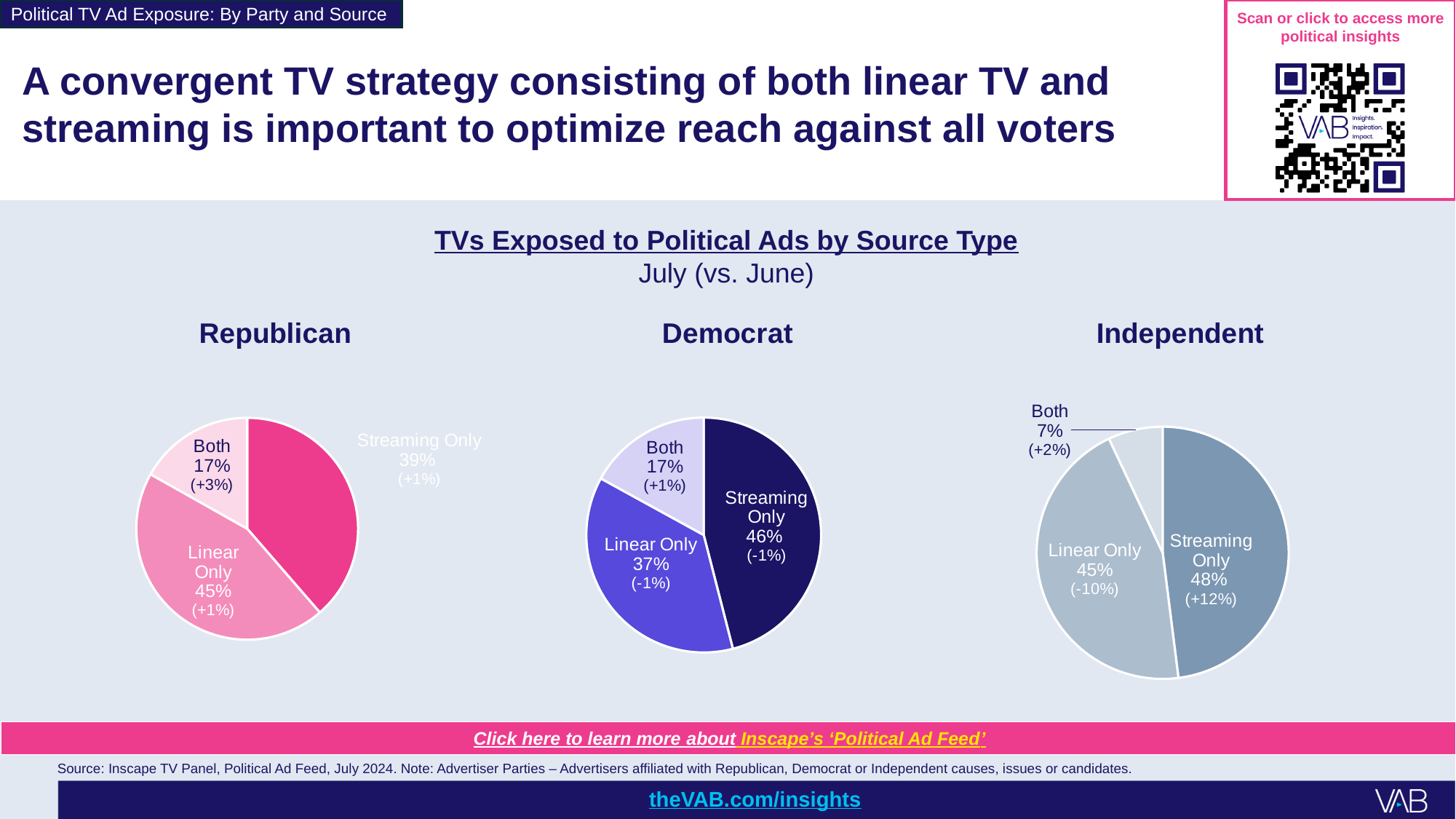
Which is larger in the Republican pie chart: Streaming Only or Linear Only? Linear Only In the Democrat pie chart, what share is Streaming Only? 46% In the Independent pie chart, which source type has the largest share? Streaming Only What type of chart is used to show TVs exposed to political ads by source type? Pie chart How many pie charts are shown on the slide? 3 In the Democrat pie chart, which source type has the smallest share? Both In the Republican pie chart, which source type has the largest share? Linear Only In the Democrat pie chart, what is the difference between the Streaming Only and Linear Only shares? 9% How many slices does the Independent pie chart have? 3 In the Independent pie chart, what share is Both? 7% In the Independent pie chart, what is the change vs. June shown for Streaming Only? +12% In the Republican pie chart, what share of TVs exposed to political ads is Linear Only? 45%